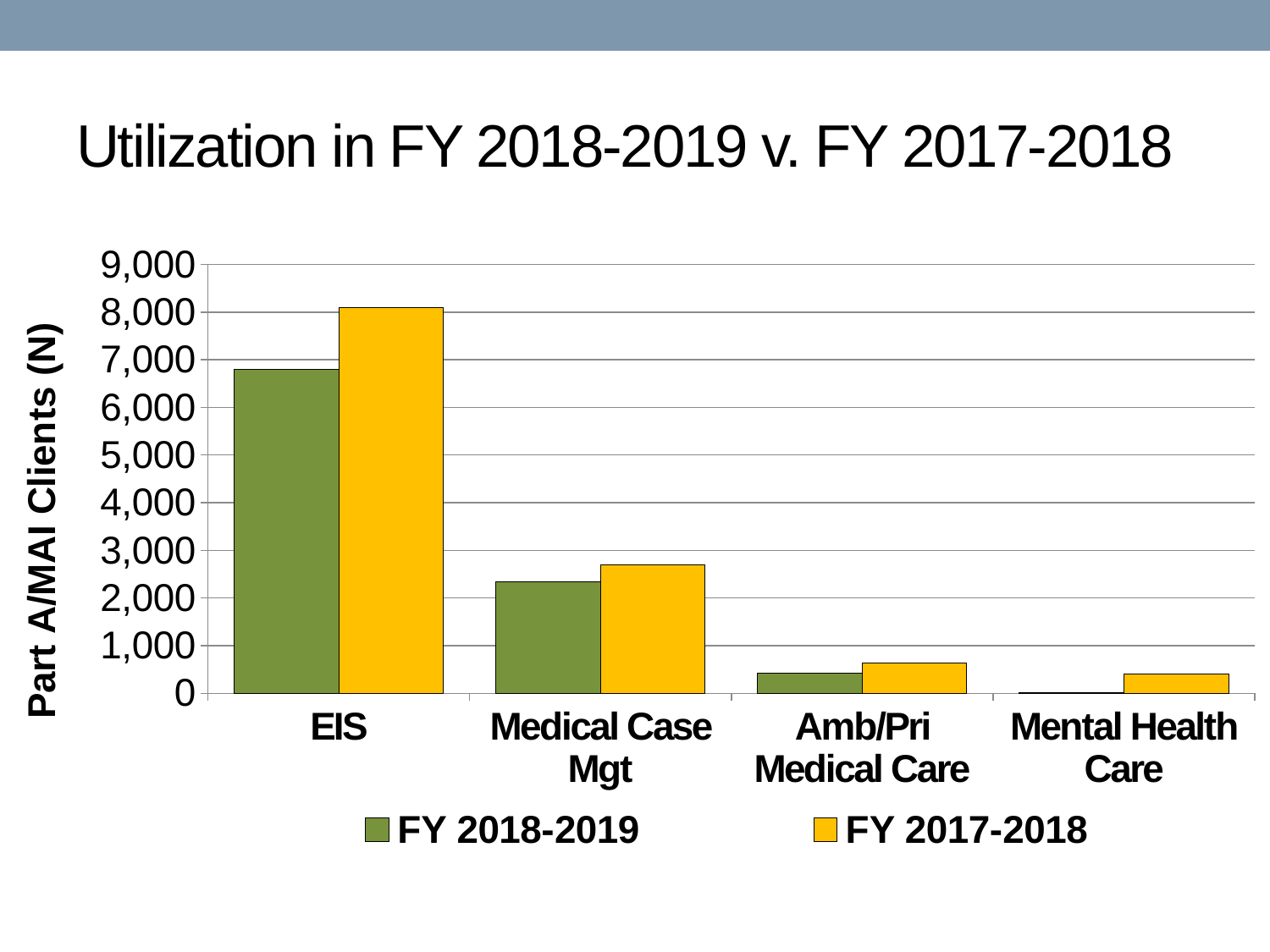
Which category has the highest value for FY 2017-2018? EIS Is the FY 2018-2019 value for EIS greater or less than 7,000? less Which category has the lowest value for FY 2018-2019? Mental Health Care How many categories are shown on the x axis? 4 How many series does the legend list? 2 What is the title of the chart's vertical axis? Part A/MAI Clients (N) For EIS, which series has the larger value, FY 2018-2019 or FY 2017-2018? FY 2017-2018 Is the FY 2018-2019 value for Medical Case Mgt greater or less than 2,000? greater What kind of chart is shown on the slide? bar chart Which category has the highest value for FY 2018-2019? EIS Which category has the lowest value for FY 2017-2018? Mental Health Care